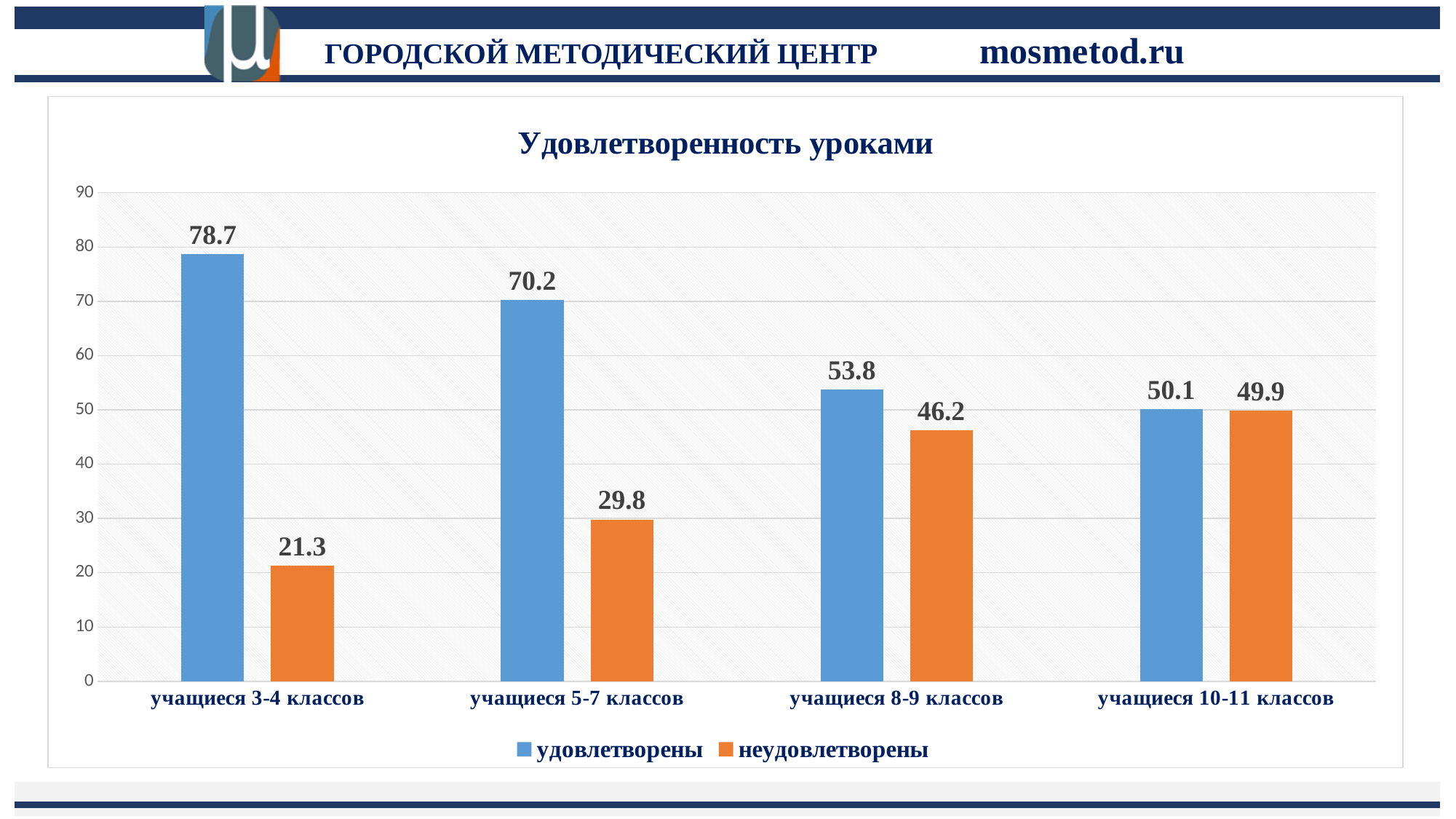
What is the value for "удовлетворены" among учащиеся 8-9 классов? 53.8 What is the title of the chart? Удовлетворенность уроками Which category has the highest value for "удовлетворены"? учащиеся 3-4 классов What is the value for "неудовлетворены" among учащиеся 5-7 классов? 29.8 What is the value for "удовлетворены" among учащиеся 3-4 классов? 78.7 What is the difference between "удовлетворены" and "неудовлетворены" for учащиеся 3-4 классов? 57.4 Which is larger for учащиеся 8-9 классов: "удовлетворены" or "неудовлетворены"? удовлетворены Is the value for "удовлетворены" among учащиеся 5-7 классов greater or less than 60? greater How many categories are shown on the x axis? 4 How many series does the legend list? 2 What kind of chart is shown on the slide? bar chart Which category has the lowest value for "неудовлетворены"? учащиеся 3-4 классов